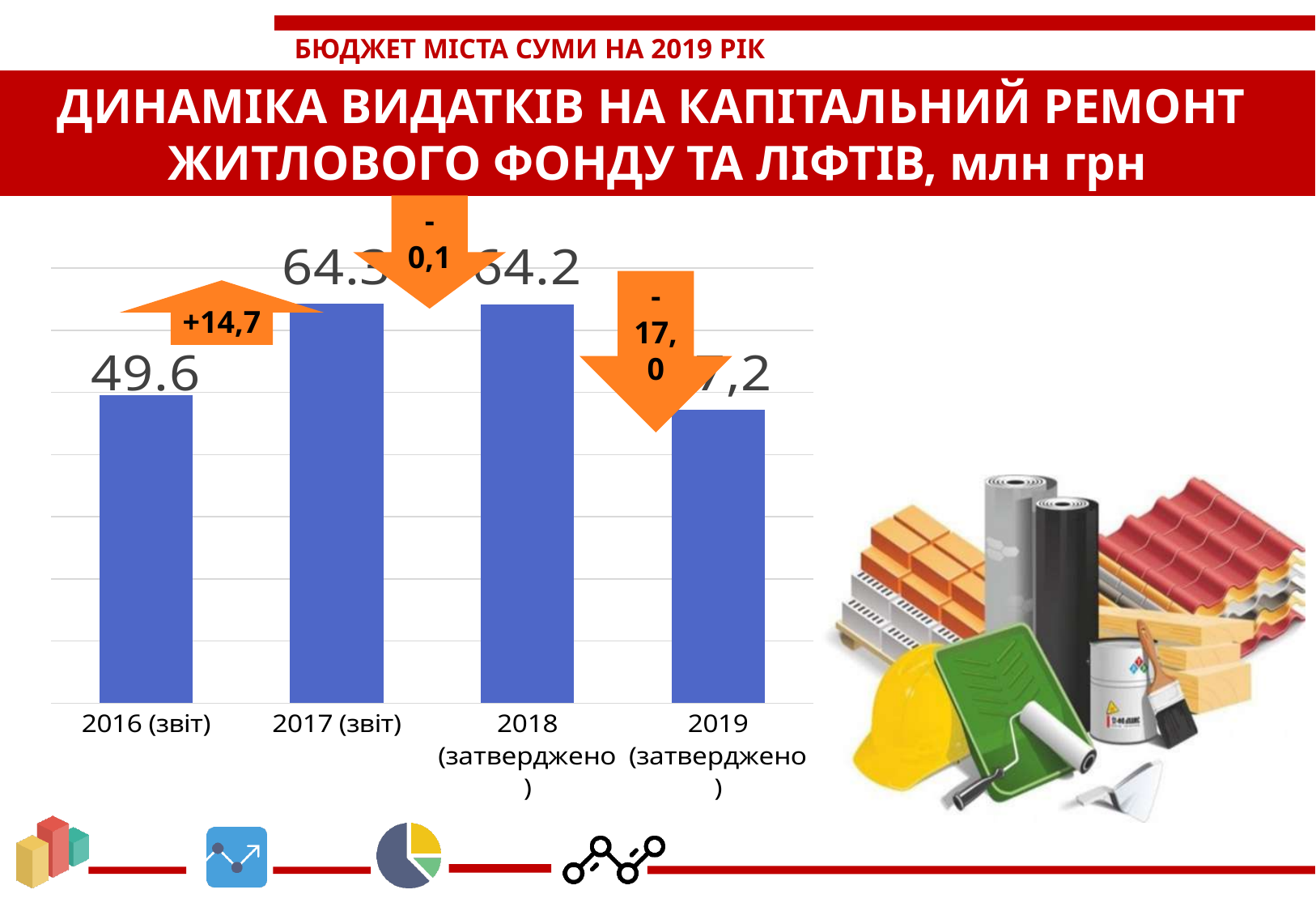
What is the value for 2016 (звіт)? 49.6 What unit is stated in the chart title? млн грн What is the value for 2018 (затверджено)? 64.2 Which is larger, the value for 2016 (звіт) or for 2018 (затверджено)? 2018 (затверджено) How many years are shown on the chart? 4 What is the difference between the values for 2017 (звіт) and 2016 (звіт)? 14.7 What kind of chart is shown on the slide? bar chart Do the values rise or fall from 2018 (затверджено) to 2019 (затверджено)? fall What change is shown on the arrow between 2016 and 2017? +14,7 Which year has the lowest value? 2019 (затверджено) What is the value for 2017 (звіт)? 64.3 What is the difference between the values for 2018 (затверджено) and 2016 (звіт)? 14.6